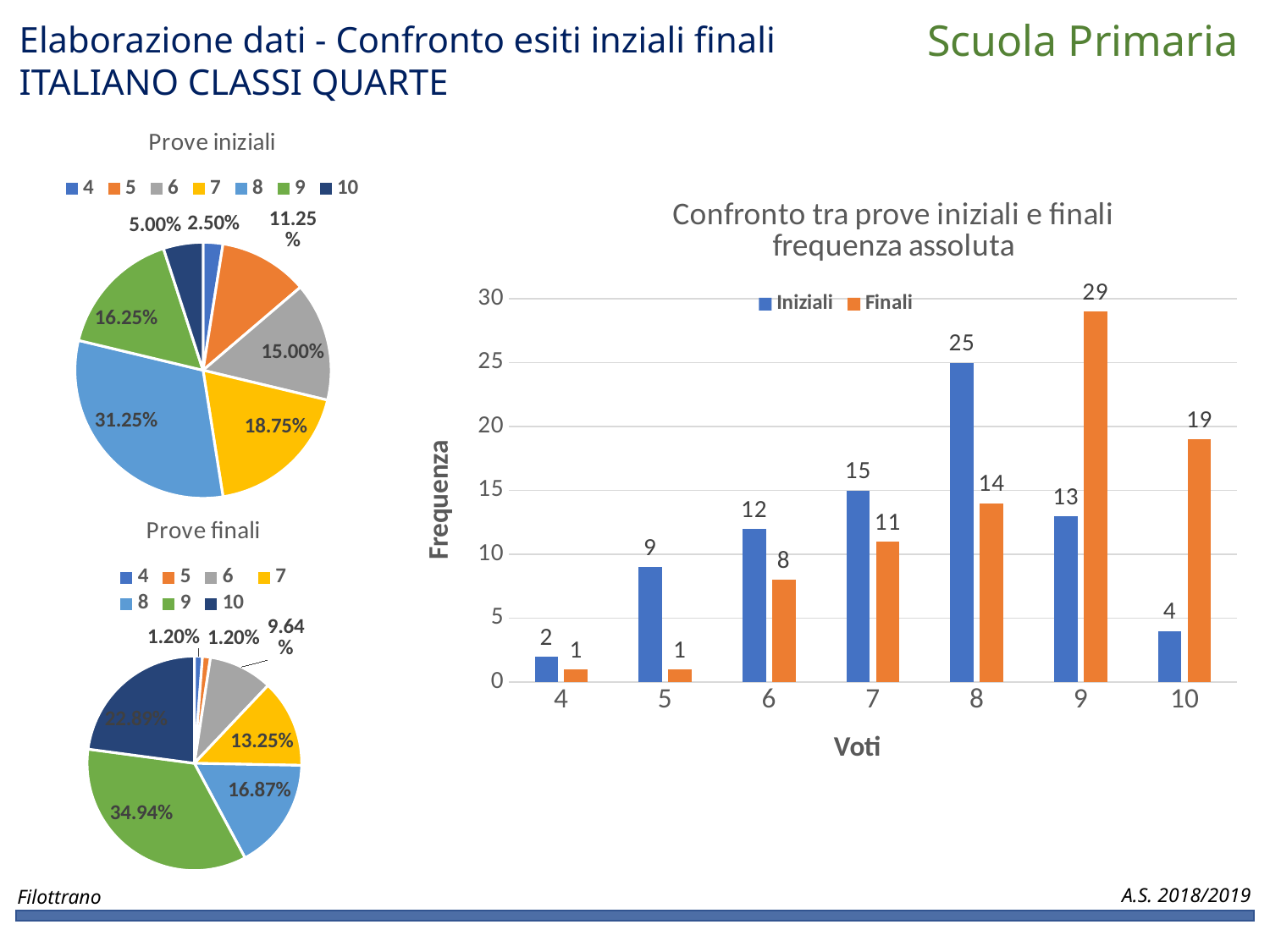
In the 'Confronto tra prove iniziali e finali frequenza assoluta' chart, which voto has the lowest Iniziali value? 4 In the 'Prove finali' pie chart, which voto has the largest slice? 9 In the 'Prove iniziali' pie chart, what share does voto 8 have? 31.25% In the 'Confronto tra prove iniziali e finali frequenza assoluta' chart, how many series does the legend list? 2 In the 'Confronto tra prove iniziali e finali frequenza assoluta' chart, how many voti categories are shown on the x axis? 7 In the 'Confronto tra prove iniziali e finali frequenza assoluta' chart, what is the difference between the Finali and Iniziali values for voto 10? 15 In the 'Confronto tra prove iniziali e finali frequenza assoluta' chart, which is larger for voto 7: Iniziali or Finali? Iniziali What kind of chart is 'Confronto tra prove iniziali e finali frequenza assoluta'? Bar chart In the 'Confronto tra prove iniziali e finali frequenza assoluta' chart, what is the Finali value for voto 9? 29 In the 'Confronto tra prove iniziali e finali frequenza assoluta' chart, what is the Iniziali value for voto 8? 25 In the 'Confronto tra prove iniziali e finali frequenza assoluta' chart, which voto has the highest Iniziali value? 8 In the 'Prove finali' pie chart, what share does voto 7 have? 13.25%